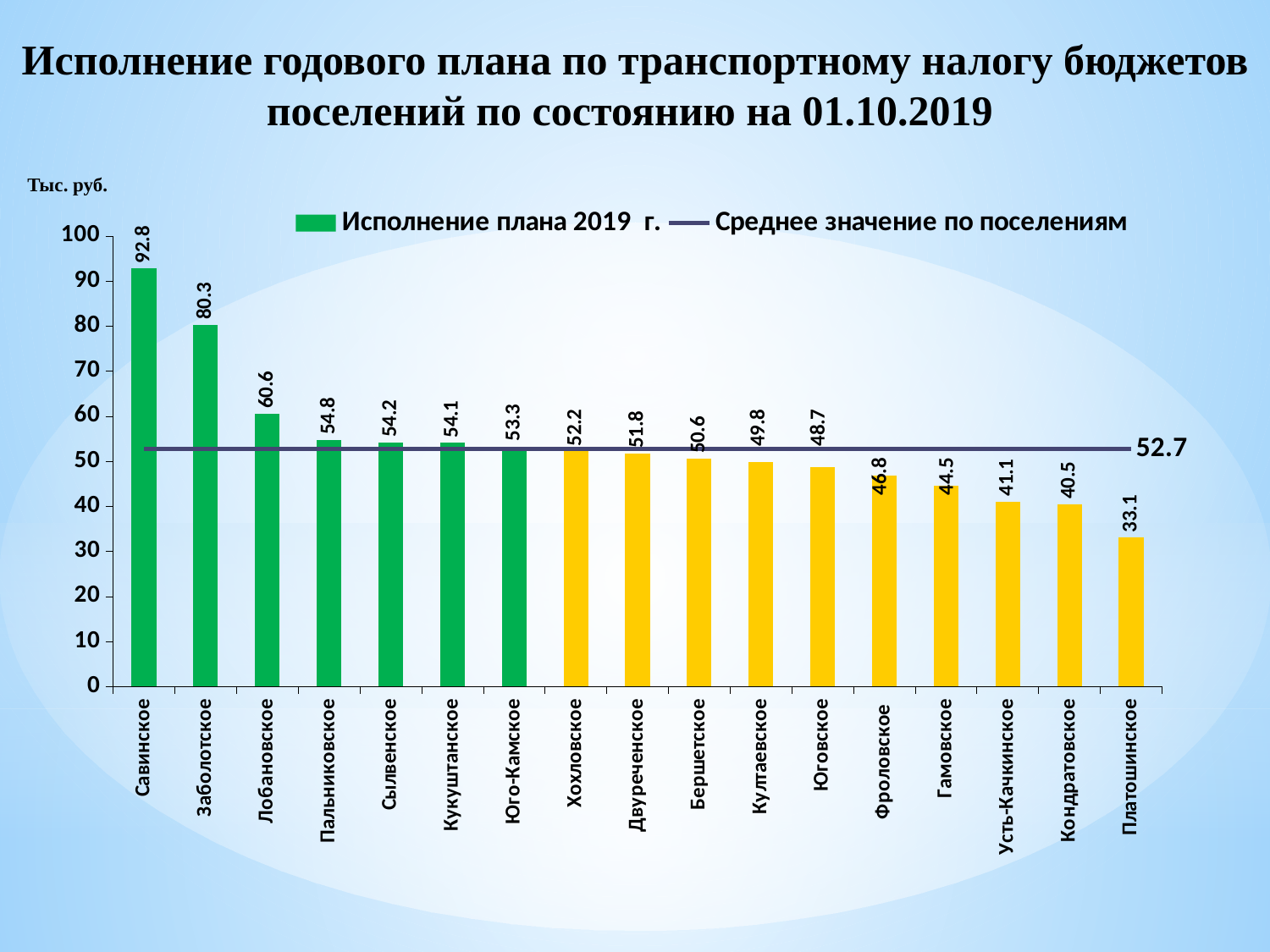
What is the value of the average line (Среднее значение по поселениям)? 52.7 How many entries does the legend list? 2 What is the difference between the values for Савинское and Заболотское? 12.5 How many settlements are shown on the chart? 17 Which settlement has the lowest value? Платошинское What kind of chart is shown on the slide? bar chart Which is larger, the value for Лобановское or the value for Фроловское? Лобановское What is the value for Платошинское? 33.1 What is the value for Хохловское? 52.2 Is the value for Кондратовское greater or less than 50? less Which settlement has the highest value? Савинское What is the value for Савинское? 92.8